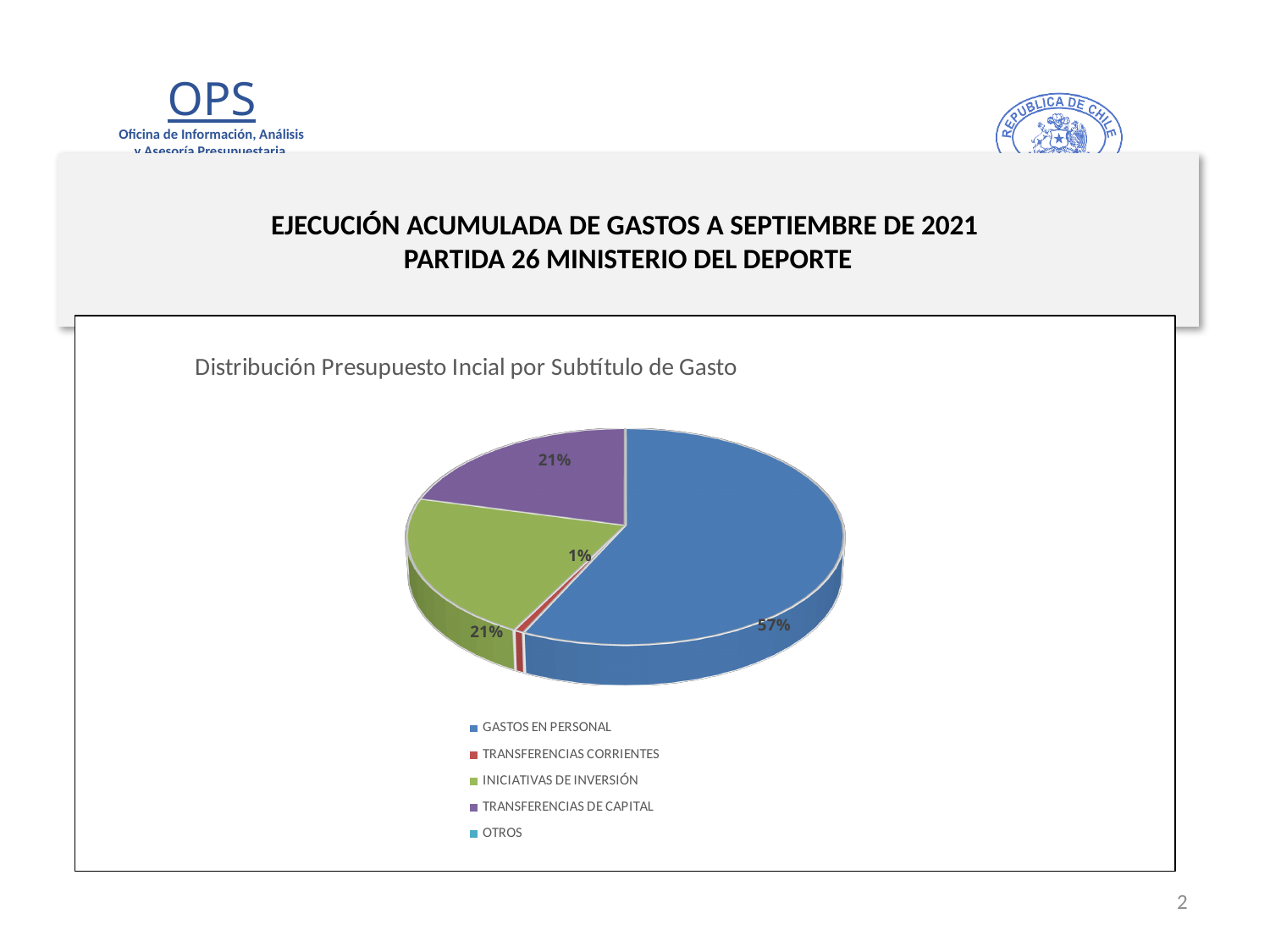
What is the difference in percentage points between the INICIATIVAS DE INVERSIÓN share and the TRANSFERENCIAS CORRIENTES share? 20 percentage points Which is larger, the share for GASTOS EN PERSONAL or the share for INICIATIVAS DE INVERSIÓN? GASTOS EN PERSONAL What share of the pie does INICIATIVAS DE INVERSIÓN represent? 21% What is the title of the chart? Distribución Presupuesto Incial por Subtítulo de Gasto What is the difference in percentage points between the GASTOS EN PERSONAL share and the TRANSFERENCIAS DE CAPITAL share? 36 percentage points Which category has the largest slice of the pie? GASTOS EN PERSONAL What colour is the GASTOS EN PERSONAL slice? Blue How many categories are listed in the chart's legend? 5 What share of the pie does TRANSFERENCIAS DE CAPITAL represent? 21% What share of the pie does GASTOS EN PERSONAL represent? 57% What type of chart is shown on the slide? Pie chart